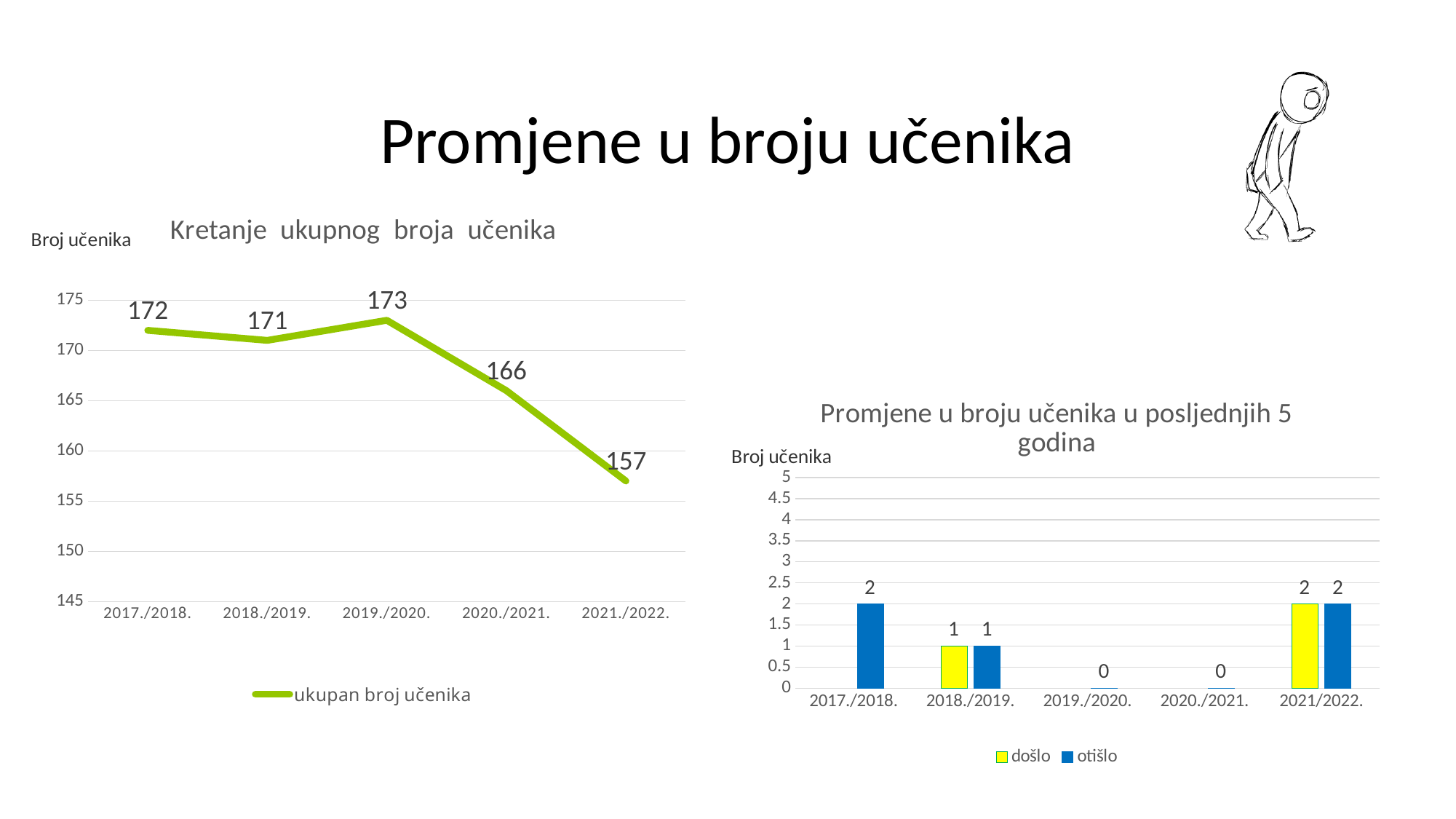
In the chart 'Kretanje ukupnog broja učenika', do the values rise or fall from 2019./2020. to 2021./2022.? fall In the chart 'Kretanje ukupnog broja učenika', what is the value for 2019./2020.? 173 In the chart 'Promjene u broju učenika u posljednjih 5 godina', what is the value of 'došlo' for 2018./2019.? 1 In the chart 'Kretanje ukupnog broja učenika', how many school years are plotted? 5 In the chart 'Kretanje ukupnog broja učenika', which school year has the highest value? 2019./2020. In the chart 'Kretanje ukupnog broja učenika', what is the value for 2021./2022.? 157 What kind of chart is 'Kretanje ukupnog broja učenika'? line chart What kind of chart is 'Promjene u broju učenika u posljednjih 5 godina'? bar chart In the chart 'Promjene u broju učenika u posljednjih 5 godina', what is the value of 'otišlo' for 2017./2018.? 2 In the chart 'Kretanje ukupnog broja učenika', what is the difference between the values for 2019./2020. and 2021./2022.? 16 How many series does the legend of the chart 'Promjene u broju učenika u posljednjih 5 godina' list? 2 In the chart 'Kretanje ukupnog broja učenika', which school year has the lowest value? 2021./2022.